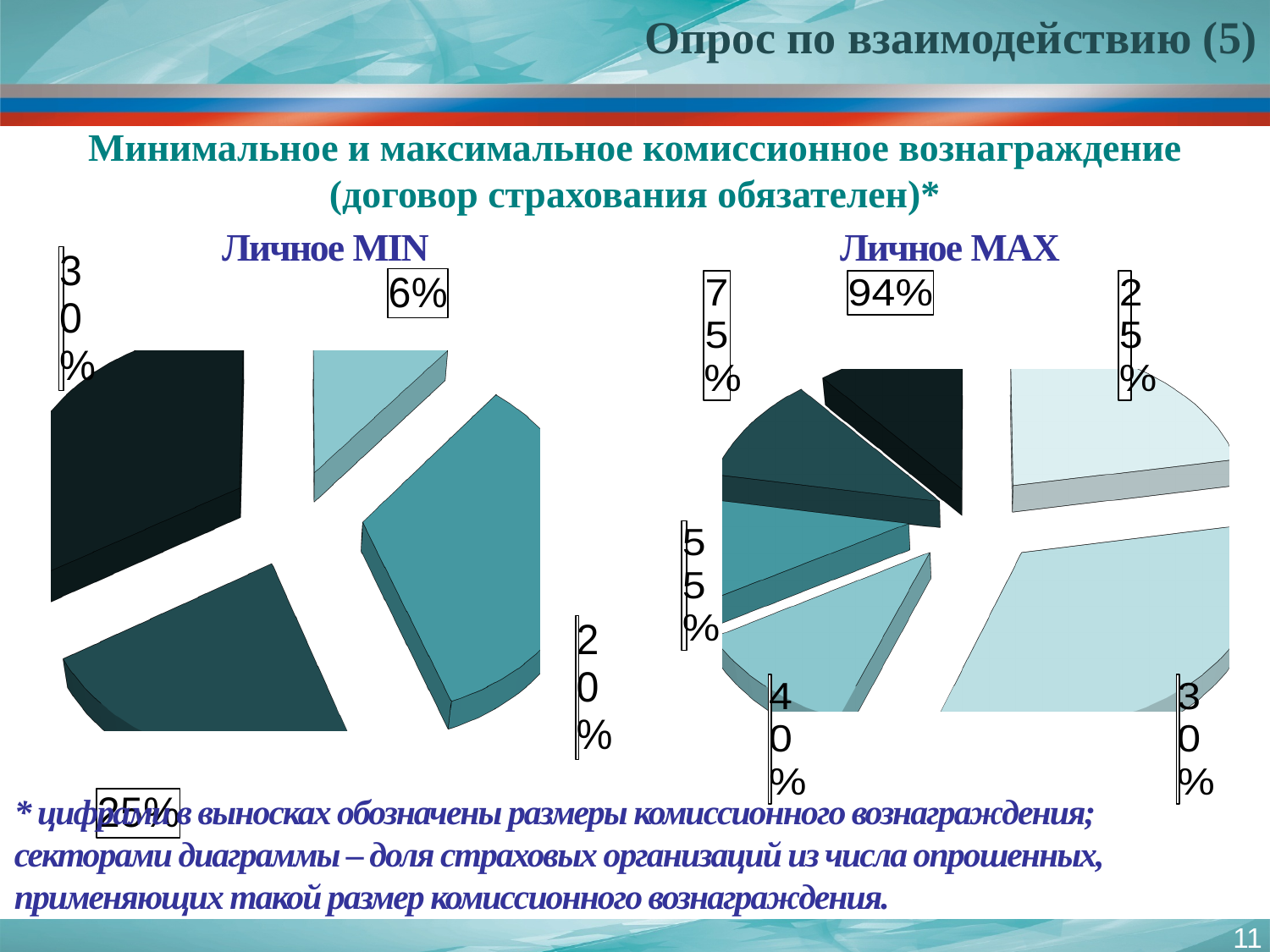
What is the title of the right pie chart? Личное MAX In the "Личное MAX" chart, which is larger: the slice labelled 94% or the slice labelled 30%? 30% How many slices does the "Личное MAX" pie chart have? 6 In the "Личное MIN" chart, which is larger: the slice labelled 6% or the slice labelled 20%? 20% What is the title of the left pie chart? Личное MIN How many slices does the "Личное MIN" pie chart have? 4 What kind of chart is the "Личное MIN" chart? pie chart In the "Личное MIN" chart, which labelled slice is the smallest? 6% What kind of chart is the "Личное MAX" chart? pie chart